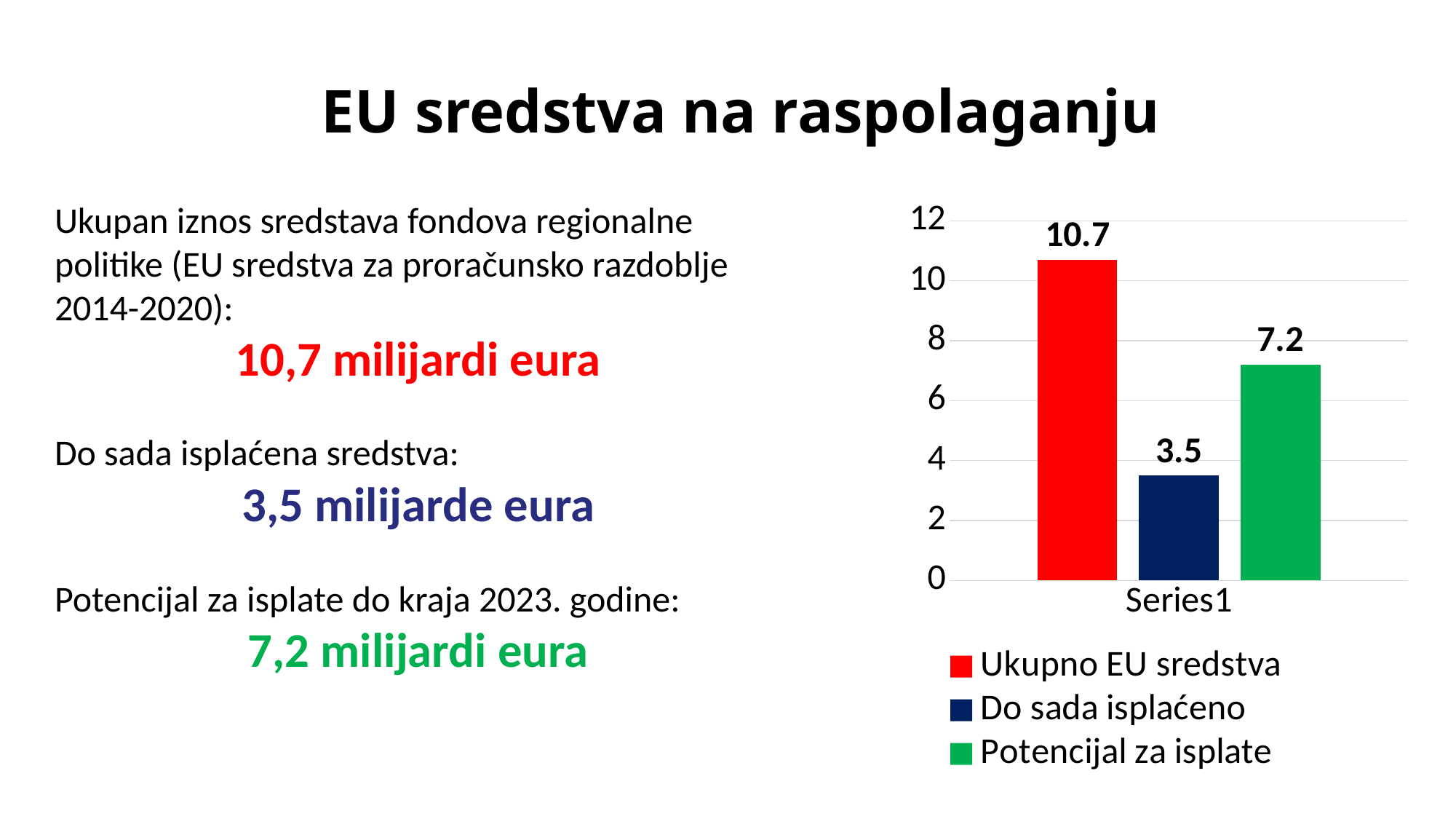
Which series has the lowest value in the chart? Do sada isplaćeno What is the value of the Do sada isplaćeno bar? 3.5 What is the difference between the Ukupno EU sredstva value and the Do sada isplaćeno value? 7.2 How many series does the legend list? 3 What is the difference between the Potencijal za isplate value and the Do sada isplaćeno value? 3.7 Which series has the highest value in the chart? Ukupno EU sredstva Is the value for Ukupno EU sredstva greater or less than 10? greater What is the value of the Ukupno EU sredstva bar? 10.7 What kind of chart is shown on the slide? bar chart What colour is the Potencijal za isplate bar? green Which is larger, Potencijal za isplate or Do sada isplaćeno? Potencijal za isplate What is the value of the Potencijal za isplate bar? 7.2